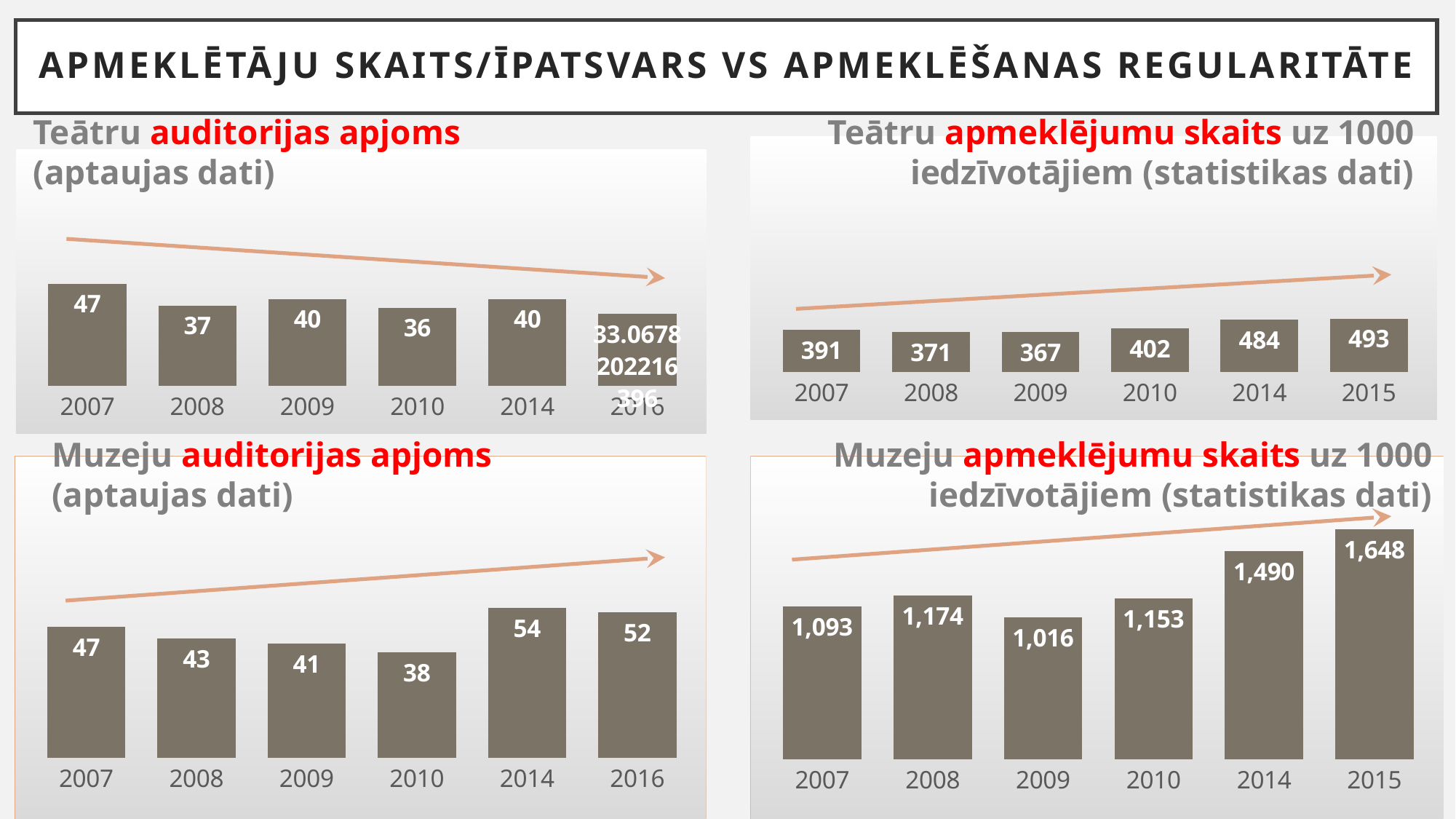
In the 'Muzeju auditorijas apjoms (aptaujas dati)' chart (bottom left), what is the value for 2014? 54 In the 'Teātru apmeklējumu skaits uz 1000 iedzīvotājiem (statistikas dati)' chart (top right), what is the difference between the values for 2010 and 2009? 35 In the 'Muzeju apmeklējumu skaits uz 1000 iedzīvotājiem (statistikas dati)' chart (bottom right), which is larger, the value for 2008 or the value for 2010? 2008 In the 'Muzeju apmeklējumu skaits uz 1000 iedzīvotājiem (statistikas dati)' chart (bottom right), which year has the lowest value? 2009 In the 'Muzeju apmeklējumu skaits uz 1000 iedzīvotājiem (statistikas dati)' chart (bottom right), what is the value for 2015? 1,648 In the 'Teātru auditorijas apjoms (aptaujas dati)' chart (top left), what is the value for 2007? 47 In the 'Muzeju auditorijas apjoms (aptaujas dati)' chart (bottom left), which year has the lowest value? 2010 In the 'Teātru apmeklējumu skaits uz 1000 iedzīvotājiem (statistikas dati)' chart (top right), what is the value for 2014? 484 In the 'Teātru apmeklējumu skaits uz 1000 iedzīvotājiem (statistikas dati)' chart (top right), which year has the highest value? 2015 In the 'Muzeju auditorijas apjoms (aptaujas dati)' chart (bottom left), how many years are shown on the x axis? 6 In the 'Teātru auditorijas apjoms (aptaujas dati)' chart (top left), which year has the lowest value among the years with whole-number labels (2007–2014)? 2010 What kind of chart is the 'Muzeju apmeklējumu skaits uz 1000 iedzīvotājiem (statistikas dati)' chart (bottom right)? Bar chart